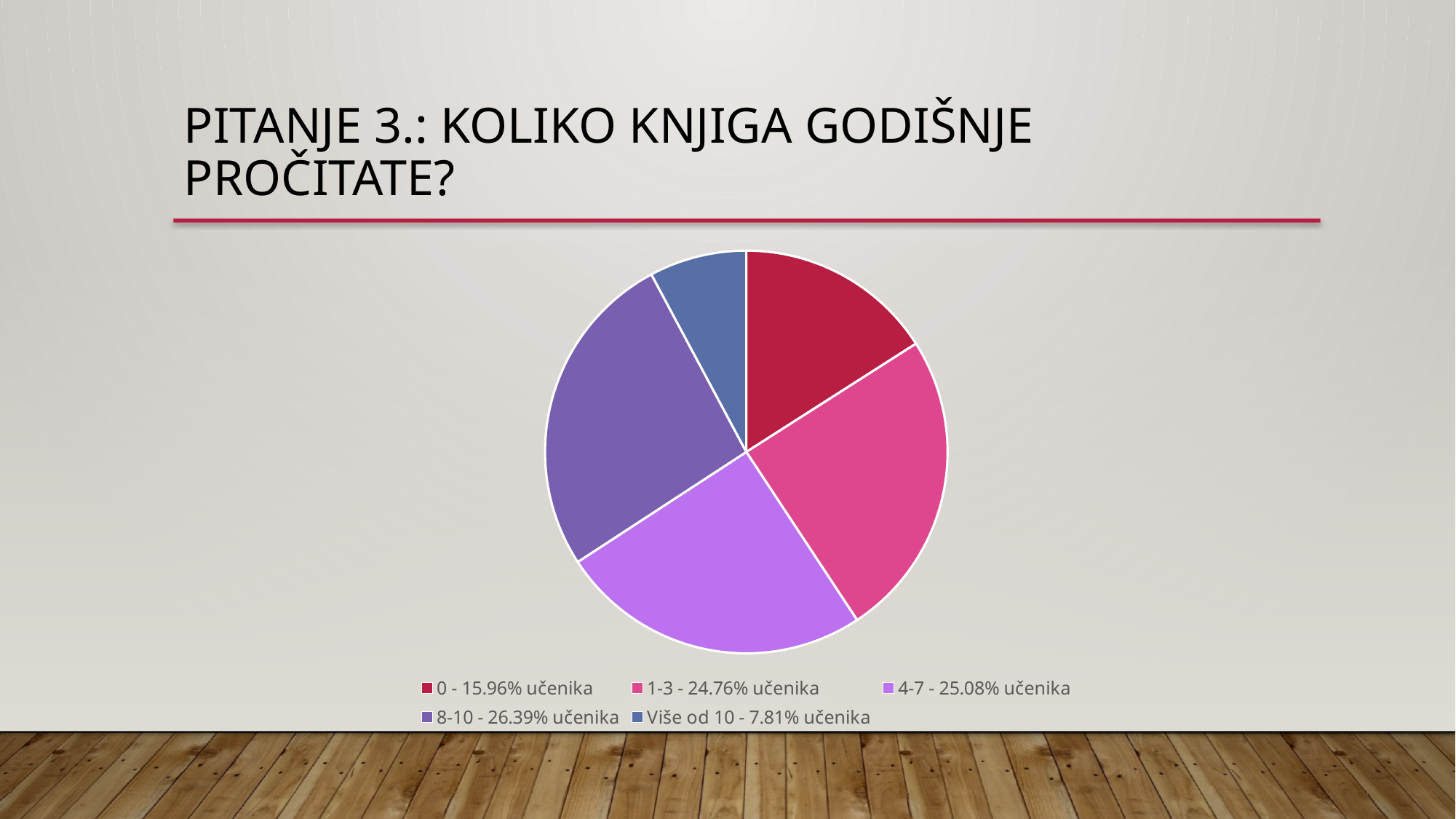
Which category has the largest share of the pie? 8-10 Which category has the smallest share of the pie? Više od 10 What type of chart is shown on the slide? Pie chart What percentage of students read 'Više od 10' books per year? 7.81% What share of students read 0 books per year according to the pie chart? 15.96% What percentage of students is shown for the '8-10' category? 26.39% What is the difference in percentage points between the '1-3' category and the '0' category? 8.80% How many categories (slices) does the pie chart have? 5 What percentage of students is shown for the '4-7' category? 25.08% What percentage of students is shown for the '1-3' category? 24.76% Which category has a larger share: '1-3' or '0'? 1-3 What is the difference in percentage points between the '8-10' category and the 'Više od 10' category? 18.58%